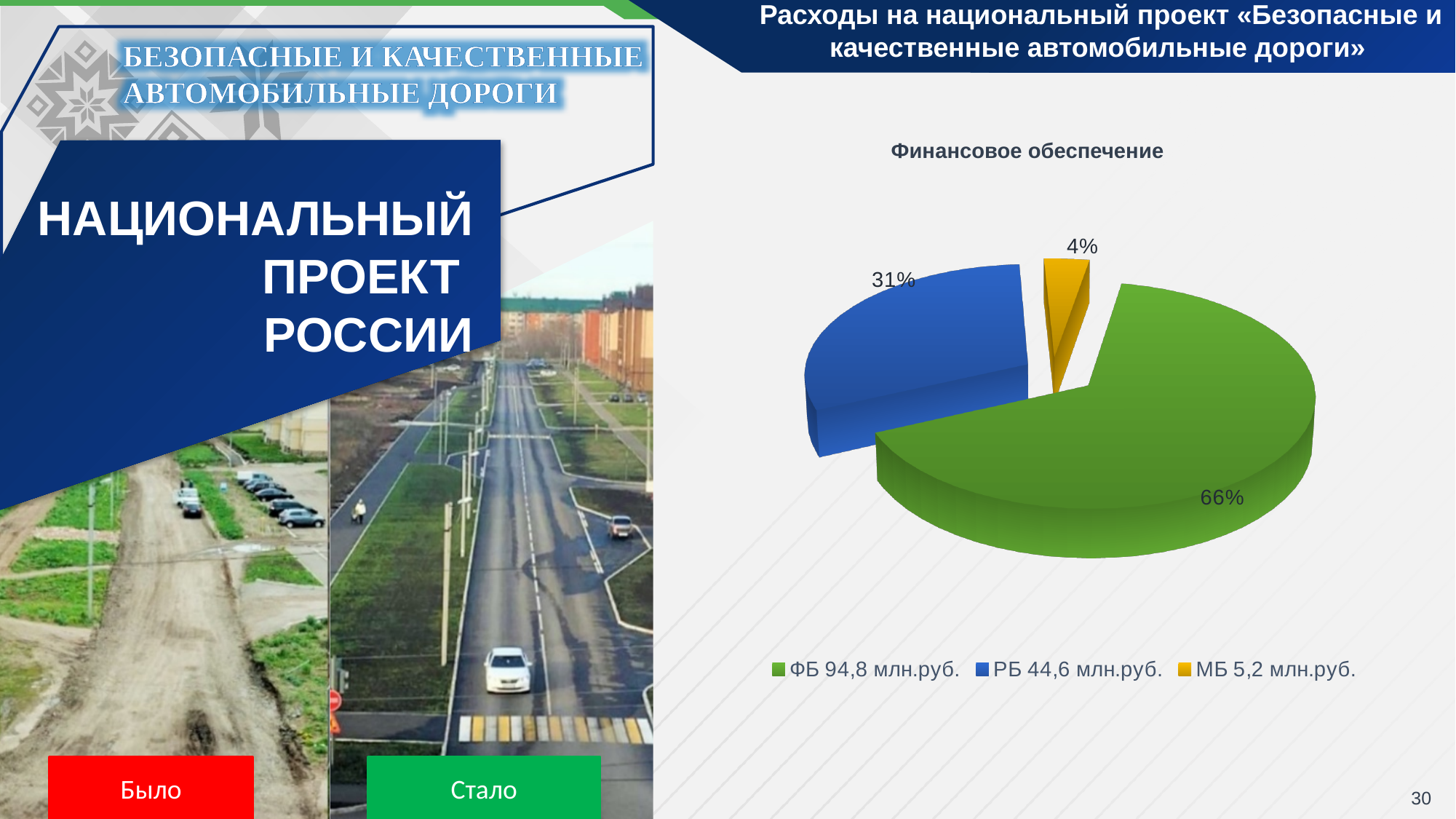
How many slices does the pie chart have? 3 What share of the pie does РБ account for? 31% What share of the pie does ФБ account for? 66% What share of the pie does МБ account for? 4% By how many percentage points does the ФБ share exceed the РБ share? 35% What kind of chart is shown under the title "Финансовое обеспечение"? Pie chart What amount is shown in the legend for РБ? 44,6 млн.руб. What is the title of the chart on the slide? Финансовое обеспечение Which source has the largest share of the pie? ФБ What amount is shown in the legend for ФБ? 94,8 млн.руб. What amount is shown in the legend for МБ? 5,2 млн.руб. Which source has the smallest share of the pie? МБ